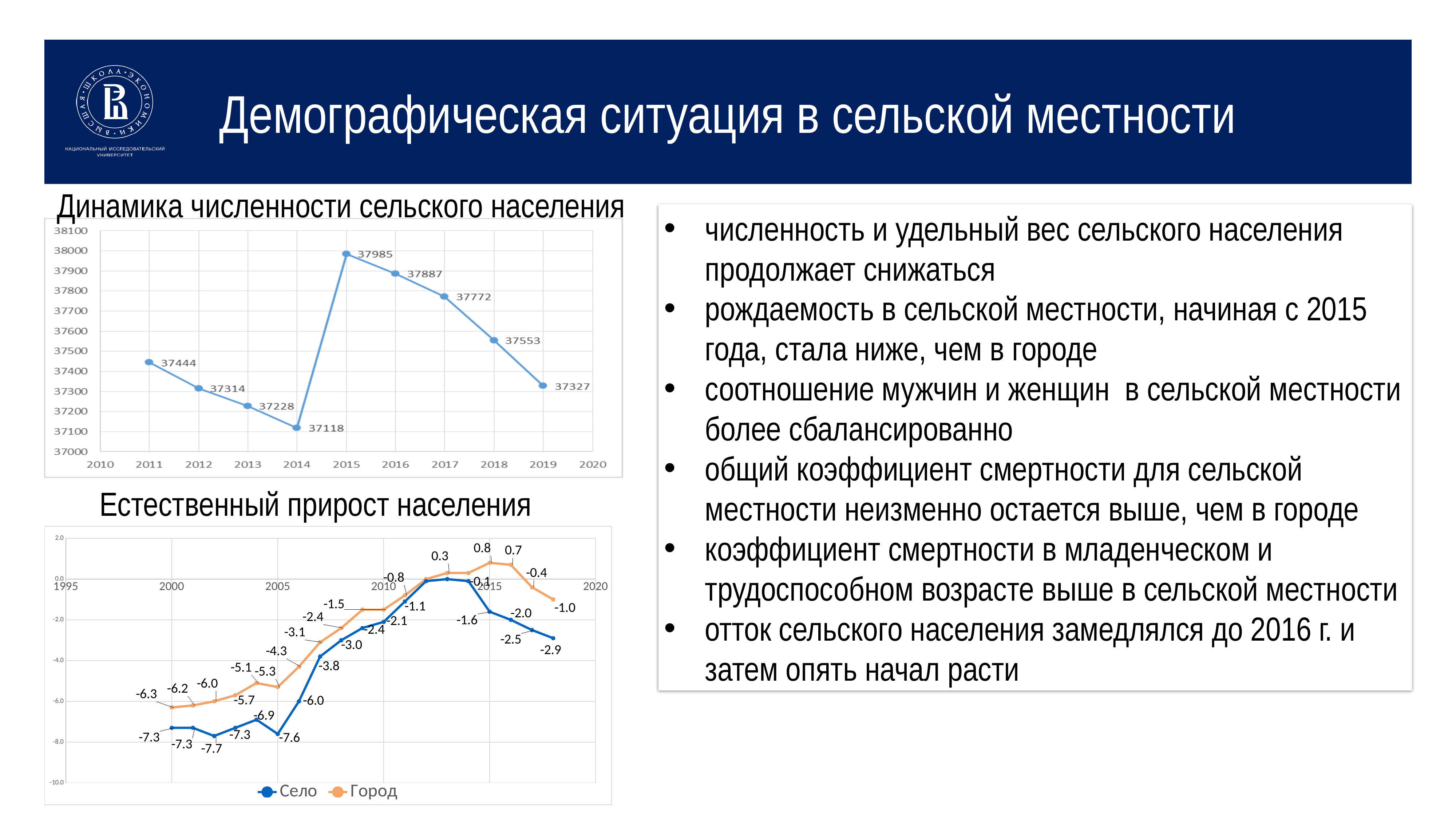
On the chart 'Естественный прирост населения', what is the lowest value of the Село series? -7.7 What type of chart is 'Естественный прирост населения'? line chart On the chart 'Динамика численности сельского населения', which year has the highest value? 2015 On the chart 'Динамика численности сельского населения', which year has the lowest value? 2014 On the chart 'Динамика численности сельского населения', how many data points are plotted? 9 On the chart 'Естественный прирост населения', what is the value of the last plotted point of the Село series? -2.9 On the chart 'Естественный прирост населения', how many series does the legend list? 2 On the chart 'Динамика численности сельского населения', what is the value for 2019? 37327 On the chart 'Естественный прирост населения', what is the highest value of the Город series? 0.8 On the chart 'Динамика численности сельского населения', what is the value for 2015? 37985 On the chart 'Динамика численности сельского населения', what is the difference between the values for 2015 and 2014? 867